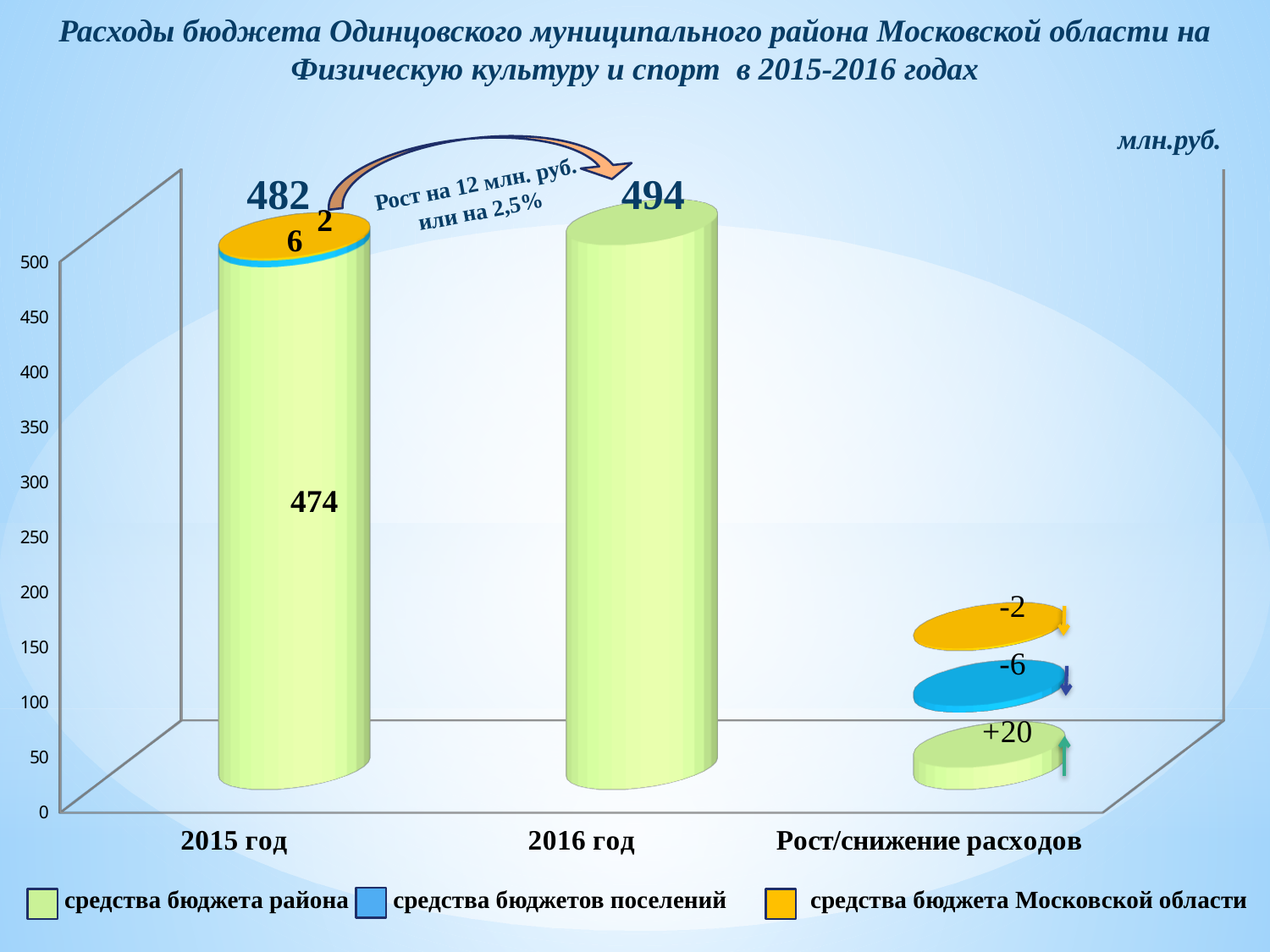
How many series does the legend list? 3 What is the value of средства бюджетов поселений in 2015 год? 6 What kind of chart is shown on the slide? Bar chart What is the value of средства бюджета района in 2015 год? 474 By how much does the 2016 год total exceed the 2015 год total? 12 What is the value of средства бюджета Московской области in 2015 год? 2 Which year has the higher total expenditure, 2015 год or 2016 год? 2016 год What unit of measurement is indicated for the chart values? млн.руб. What is the total budget expenditure on physical culture and sport shown for 2015 год? 482 What is the change shown for средства бюджета района in the Рост/снижение расходов category? +20 What is the value shown for 2016 год? 494 What is the change shown for средства бюджетов поселений in the Рост/снижение расходов category? -6